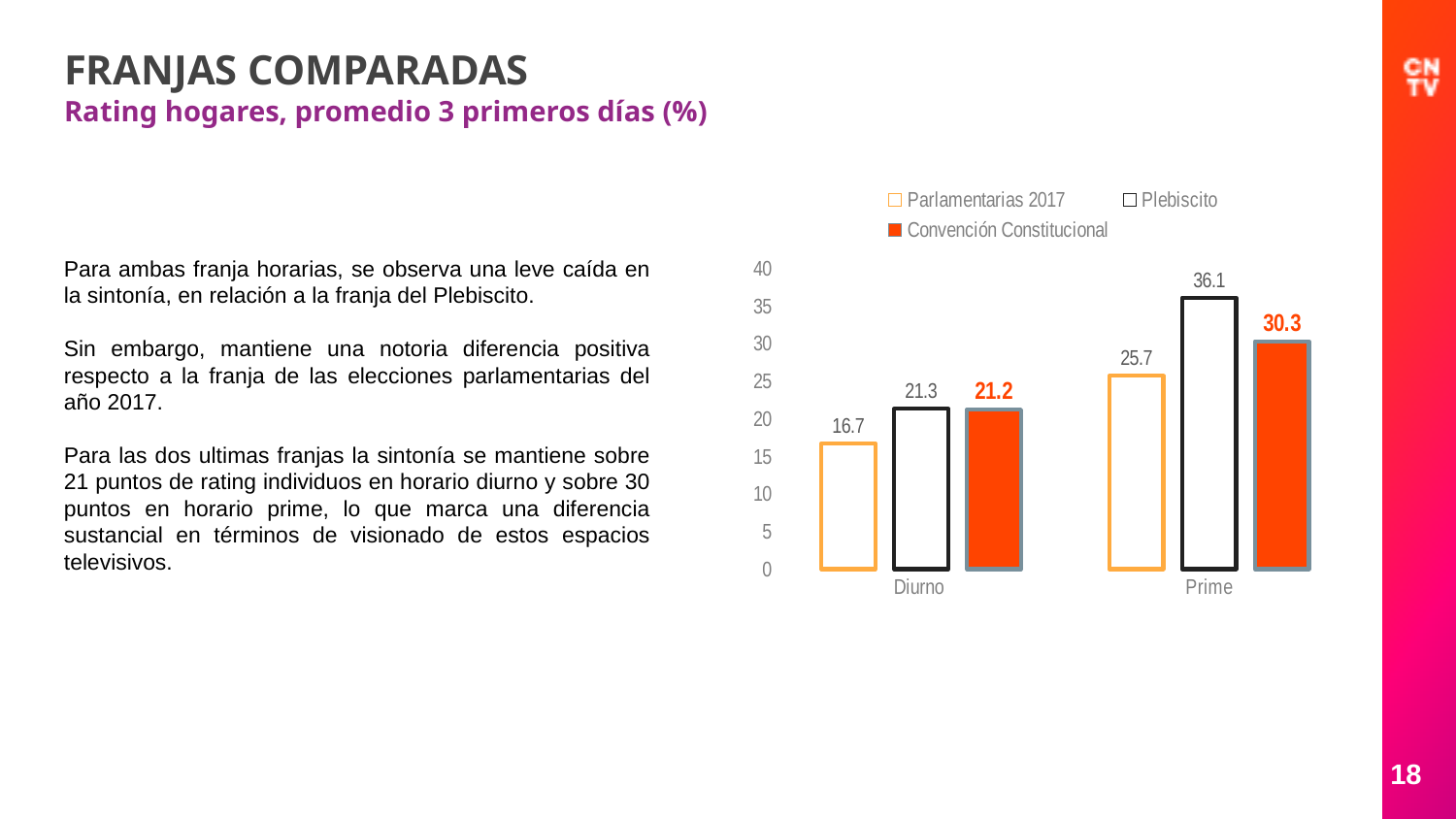
What is the difference between the Convención Constitucional values for Prime and Diurno? 9.1 What is the value for Convención Constitucional in the Diurno category? 21.2 How many series does the legend list? 3 What is the value for Plebiscito in the Prime category? 36.1 What is the difference between the Plebiscito and Parlamentarias 2017 values in the Prime category? 10.4 What is the value for Convención Constitucional in the Prime category? 30.3 Which series has the highest value in the Prime category? Plebiscito Which series has the lowest value in the Diurno category? Parlamentarias 2017 Which is larger: the Plebiscito value for Prime or the Convención Constitucional value for Prime? Plebiscito What kind of chart is shown on the slide? Bar chart What is the value for Parlamentarias 2017 in the Diurno category? 16.7 How many categories are shown on the x axis? 2